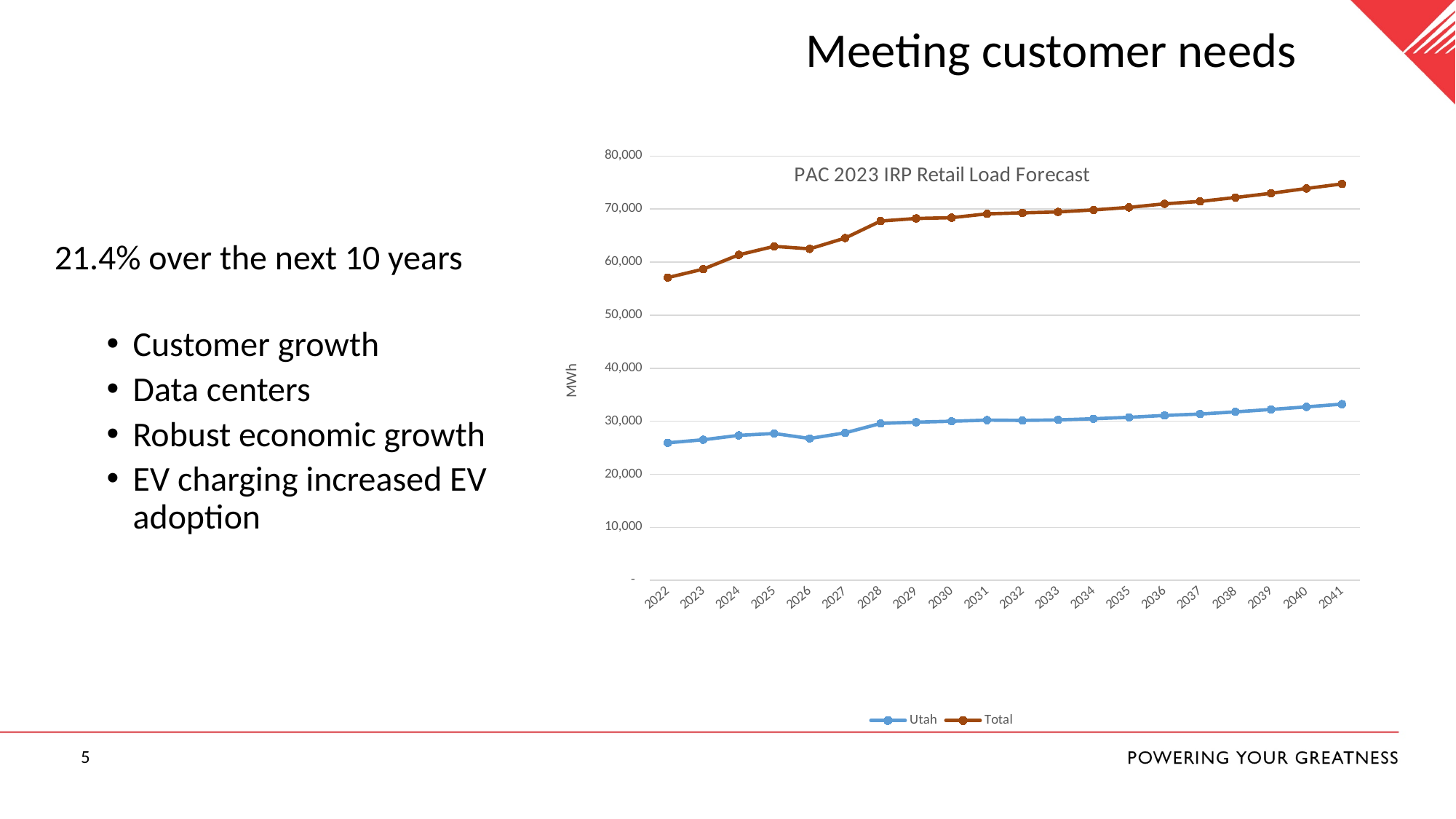
Does the Total series rise or fall from 2022 to 2041? Rise How many series does the legend of the chart list? 2 Is the Total value for 2041 greater or less than 70,000? greater What is the title of the chart? PAC 2023 IRP Retail Load Forecast Is the Utah value for 2041 greater or less than 30,000? greater What kind of chart is shown on the slide? Line chart Is the Total value for 2022 greater or less than 60,000? less In 2030, which series has the larger value, Utah or Total? Total In which year is the Total series at its highest? 2041 How many years are plotted along the x axis of the chart? 20 What unit is shown on the y axis of the chart? MWh